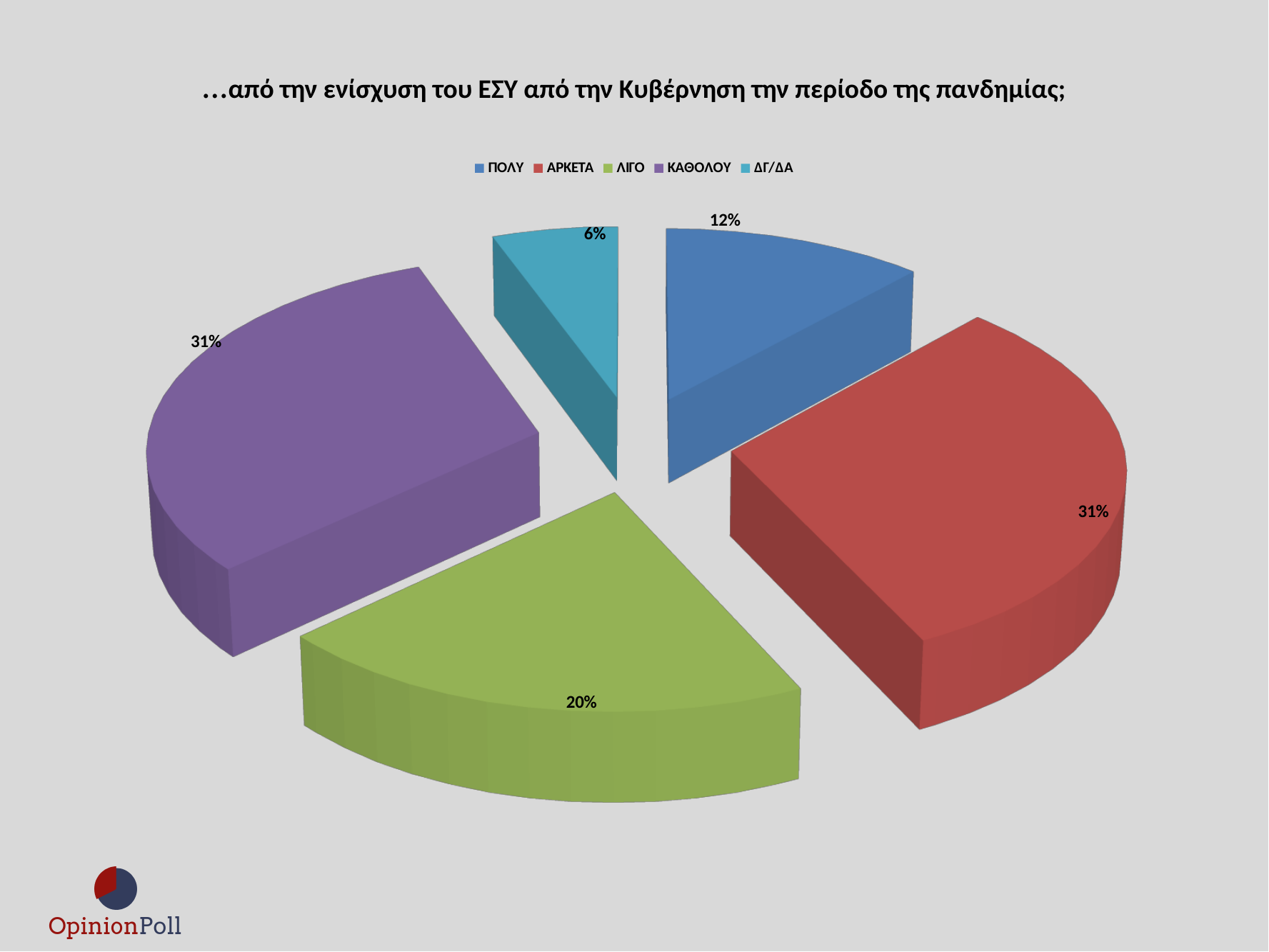
What is the difference in percentage points between ΑΡΚΕΤΑ and ΛΙΓΟ? 11 How many slices does the pie chart have? 5 What percentage is shown for ΑΡΚΕΤΑ? 31% Which category has the smallest share of the pie? ΔΓ/ΔΑ What kind of chart is shown on the slide? Pie chart What percentage is shown for ΛΙΓΟ? 20% How many entries does the legend list? 5 What percentage is shown for ΠΟΛΥ? 12% What colour is the slice for ΚΑΘΟΛΟΥ? Purple What percentage is shown for ΔΓ/ΔΑ? 6% What percentage is shown for ΚΑΘΟΛΟΥ? 31% Which is larger, the share for ΛΙΓΟ or the share for ΠΟΛΥ? ΛΙΓΟ